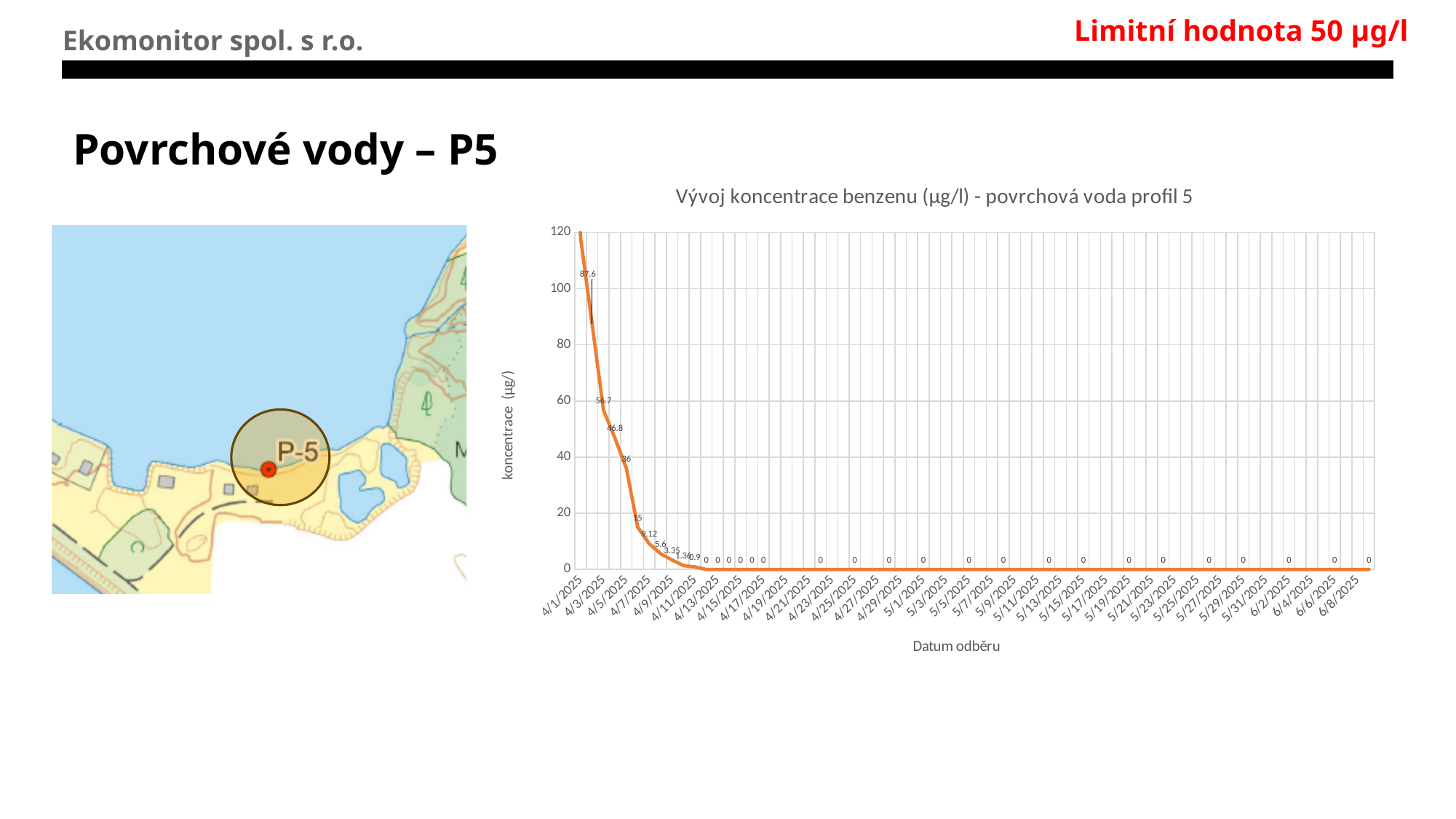
Is the value for 4/1/2025 greater or less than 100? greater What is the title of the chart? Vývoj koncentrace benzenu (µg/l) - povrchová voda profil 5 Which date has the larger value, 4/3/2025 or 5/1/2025? 4/3/2025 What type of chart is shown on the slide? line chart Is the value for 4/9/2025 greater or less than 20? less Do the benzene concentration values rise or fall over time along the x axis? fall What is the difference between the values for 5/1/2025 and 6/8/2025? 0 What is the benzene concentration value for 5/1/2025? 0 Is the value for 4/5/2025 greater or less than 20? greater What is the benzene concentration value for 6/8/2025? 0 What is the label of the x axis of the chart? Datum odběru